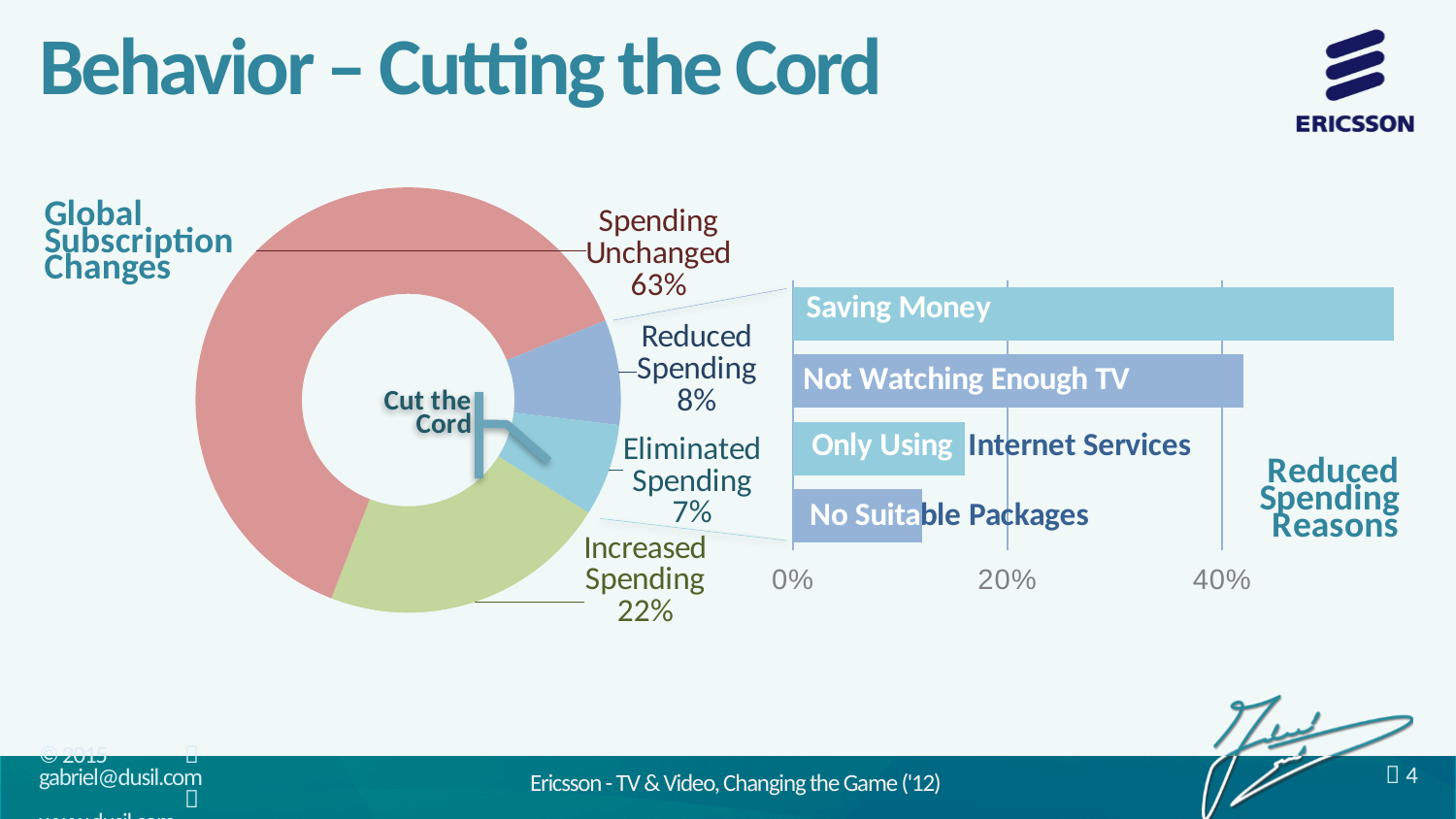
How many categories does the Global Subscription Changes chart show? 4 In the Reduced Spending Reasons chart, is the value for Saving Money greater or less than 40%? greater In the Global Subscription Changes chart, what share is shown for Increased Spending? 22% In the Reduced Spending Reasons chart, is the value for No Suitable Packages greater or less than 20%? less In the Reduced Spending Reasons chart, which reason has the highest value? Saving Money In the Global Subscription Changes chart, which category has the smallest share? Eliminated Spending In the Global Subscription Changes chart, which is larger: Reduced Spending or Eliminated Spending? Reduced Spending In the Global Subscription Changes chart, what is the difference between Spending Unchanged and Increased Spending? 41% In the Global Subscription Changes chart, which category has the largest share? Spending Unchanged In the Global Subscription Changes chart, what percentage is shown for Eliminated Spending? 7% In the Global Subscription Changes chart, what percentage of respondents reported Spending Unchanged? 63% What kind of chart is the Global Subscription Changes chart? Doughnut chart